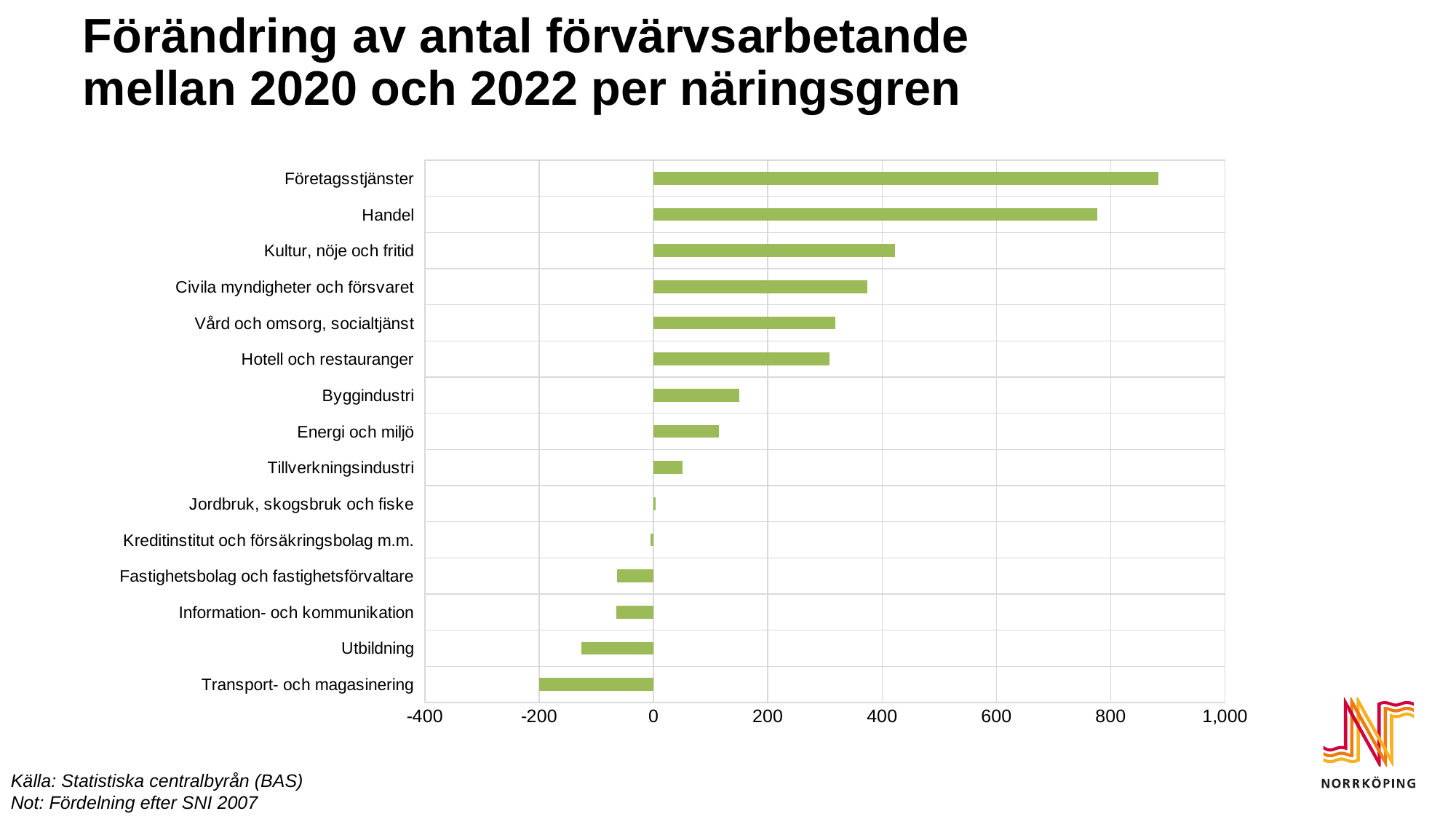
How many industry categories (näringsgrenar) are shown in the chart? 15 Is the value for Kultur, nöje och fritid greater or less than 400? greater How many categories show a negative change (bars extending to the left of 0)? 5 Which is larger, the value for Handel or the value for Kultur, nöje och fritid? Handel Is the value for Handel greater or less than 800? less Is the value for Företagsstjänster greater or less than 800? greater Which is larger, the value for Byggindustri or the value for Tillverkningsindustri? Byggindustri What is the title of the chart on the slide? Förändring av antal förvärvsarbetande mellan 2020 och 2022 per näringsgren What kind of chart is shown on the slide? bar chart Which category has the largest decrease in the number of employed persons? Transport- och magasinering Which category has the largest increase in the number of employed persons? Företagsstjänster